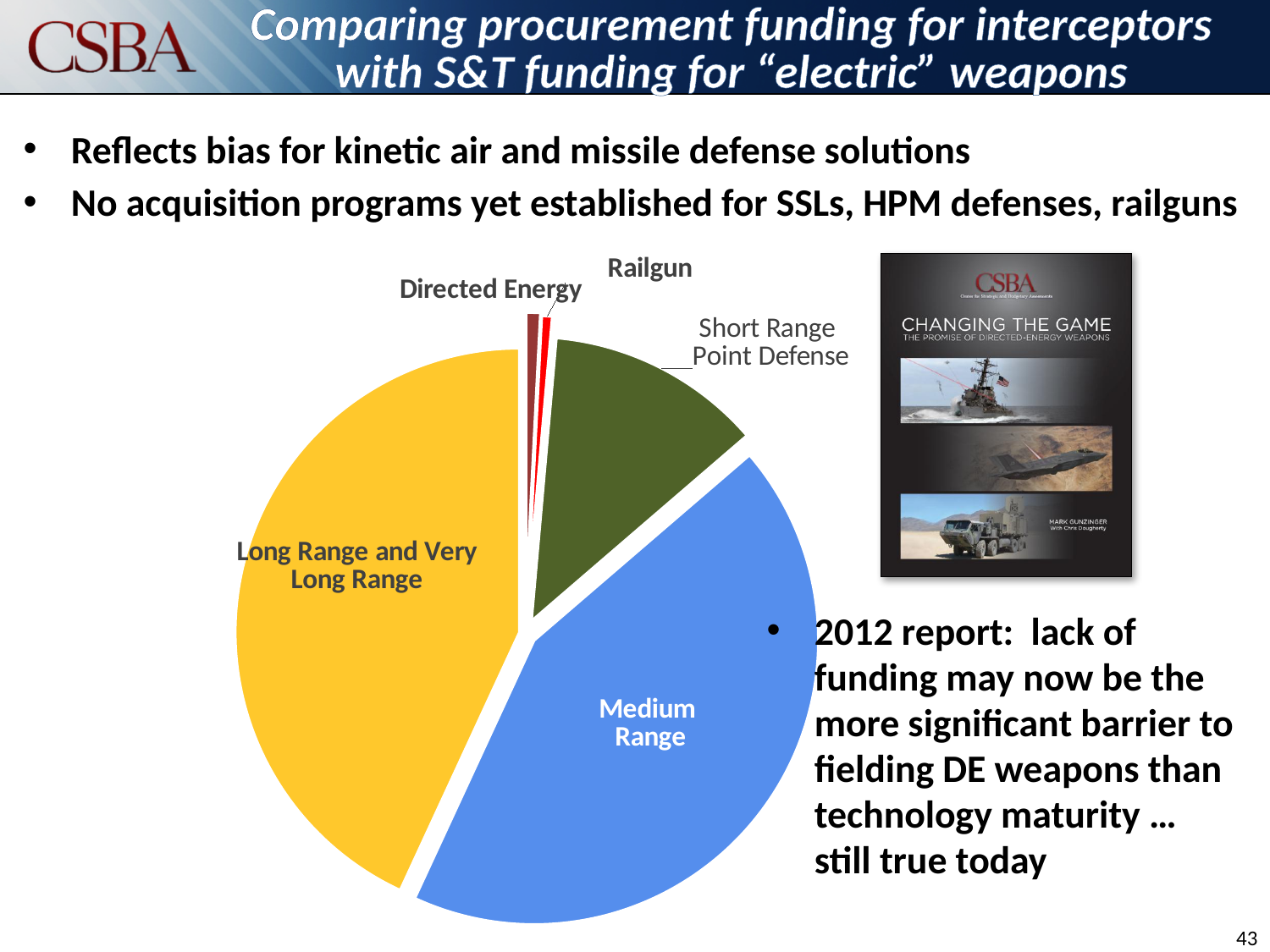
Which is larger in the pie chart, the Railgun slice or the Short Range Point Defense slice? Short Range Point Defense What kind of chart is shown on the slide? pie chart How many slices does the pie chart have? 5 Which is larger in the pie chart, the Short Range Point Defense slice or the Long Range and Very Long Range slice? Long Range and Very Long Range What colour is the Medium Range slice of the pie chart? blue Which is larger in the pie chart, the Medium Range slice or the Directed Energy slice? Medium Range What colour is the Long Range and Very Long Range slice of the pie chart? yellow